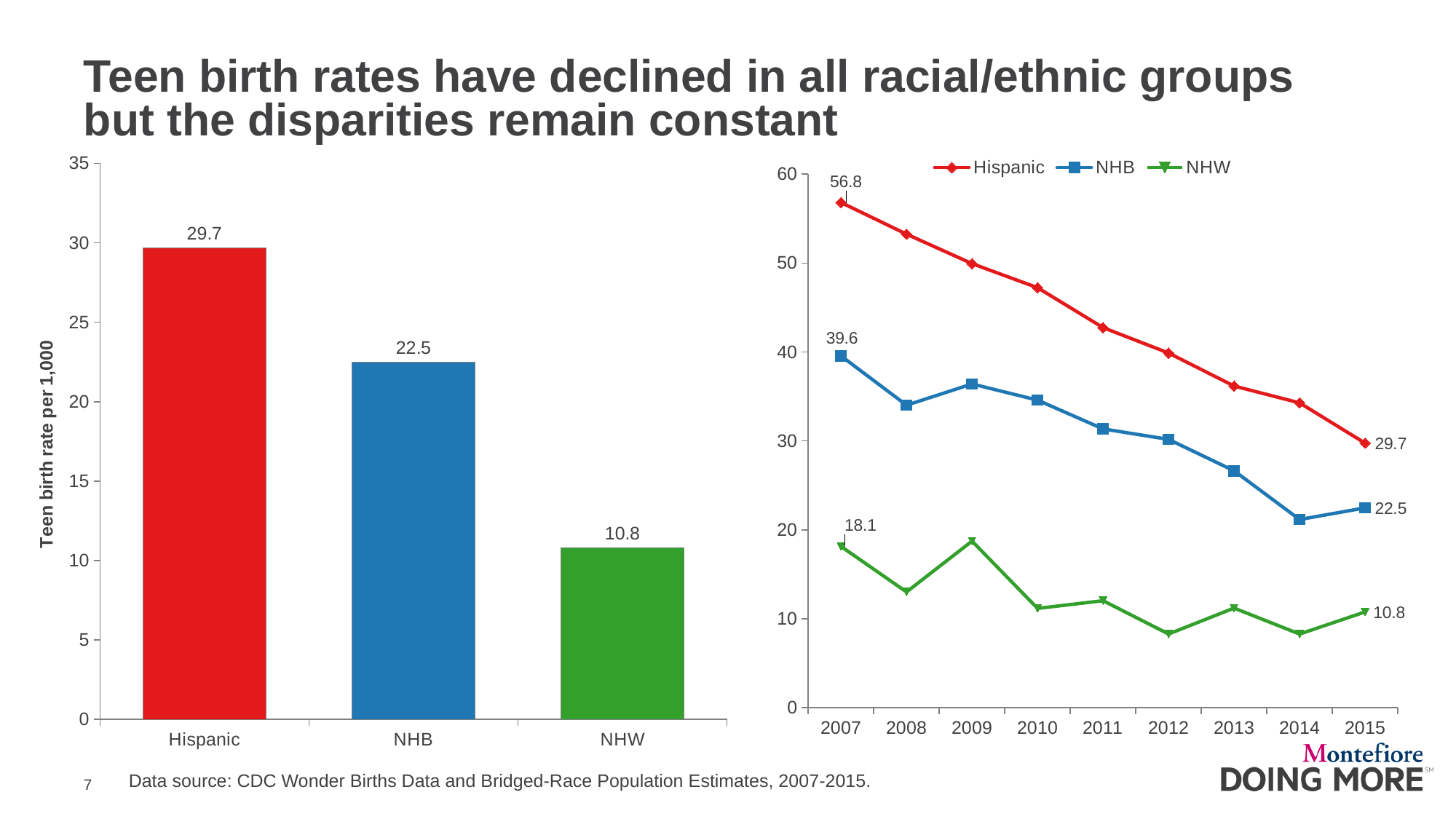
In the line chart on the right, is the NHB value for 2010 greater or less than 30? greater In the line chart on the right, how many series does the legend list? 3 In the line chart on the right, what was the NHB teen birth rate in 2015? 22.5 In the bar chart on the left, which group has the highest teen birth rate? Hispanic In the bar chart on the left, what is the difference between the Hispanic and NHB teen birth rates? 7.2 In the bar chart on the left, what is the teen birth rate per 1,000 for Hispanic? 29.7 In the bar chart on the left, which group has the lowest teen birth rate? NHW In the line chart on the right, what was the Hispanic teen birth rate in 2007? 56.8 In the line chart on the right, does the Hispanic teen birth rate rise or fall from 2007 to 2015? fall In the line chart on the right, by how much did the NHW teen birth rate decline from 2007 to 2015? 7.3 In the bar chart on the left, how many groups are shown? 3 In the bar chart on the left, what is the teen birth rate per 1,000 for NHW? 10.8